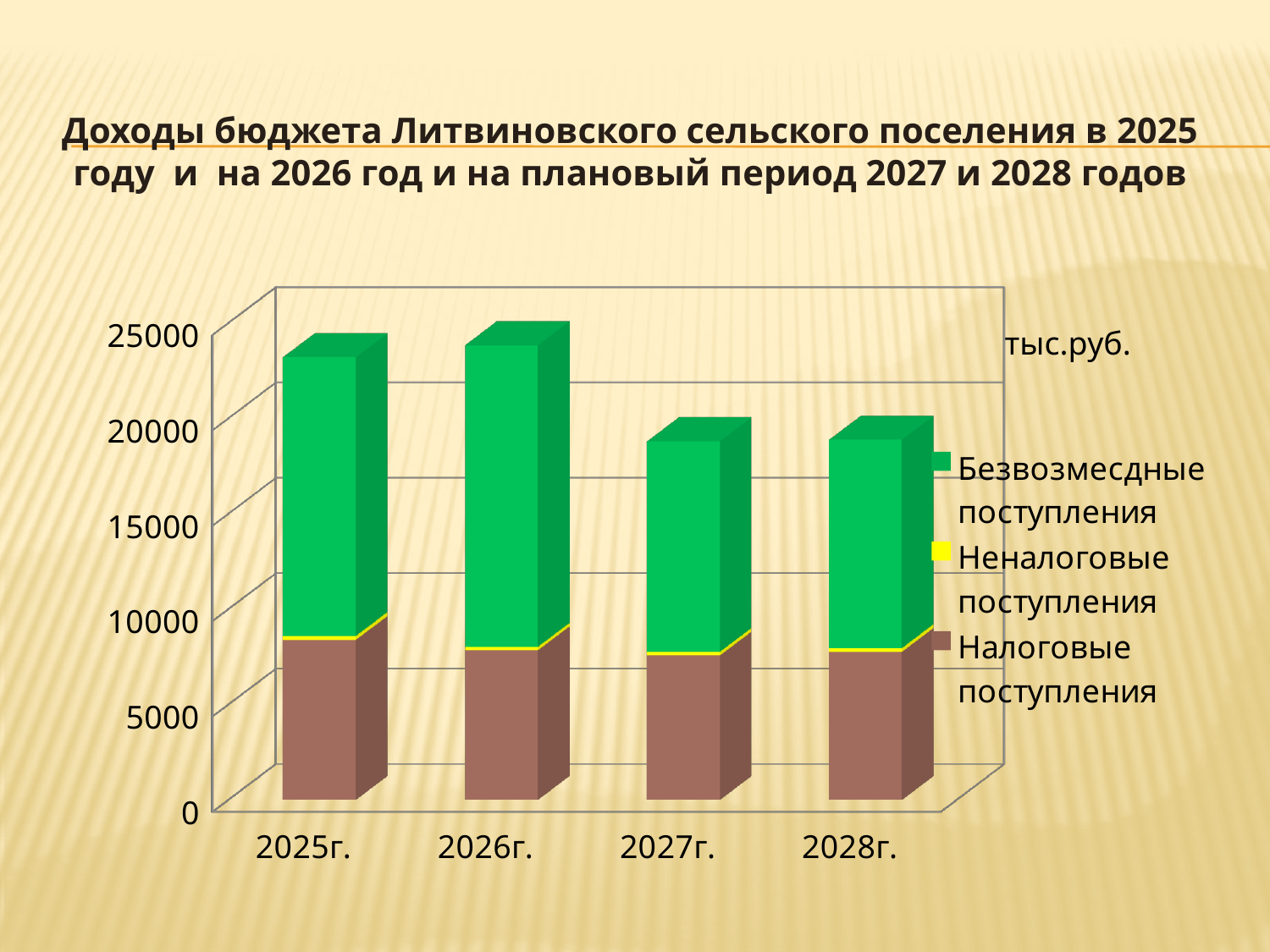
In what unit are the values on the chart expressed? тыс.руб. What kind of chart is shown on the slide? bar chart Do the total bars generally rise or fall from 2025г. to 2028г.? fall How many years (categories) are shown on the x axis? 4 How many series does the legend list? 3 Is the Налоговые поступления segment for 2025г. greater or less than 10000? less Is the total bar for 2025г. greater or less than 20000? greater Which colour represents Налоговые поступления in the legend? brown Is the total bar for 2028г. greater or less than 20000? less Which total bar is taller, 2026г. or 2027г.? 2026г.